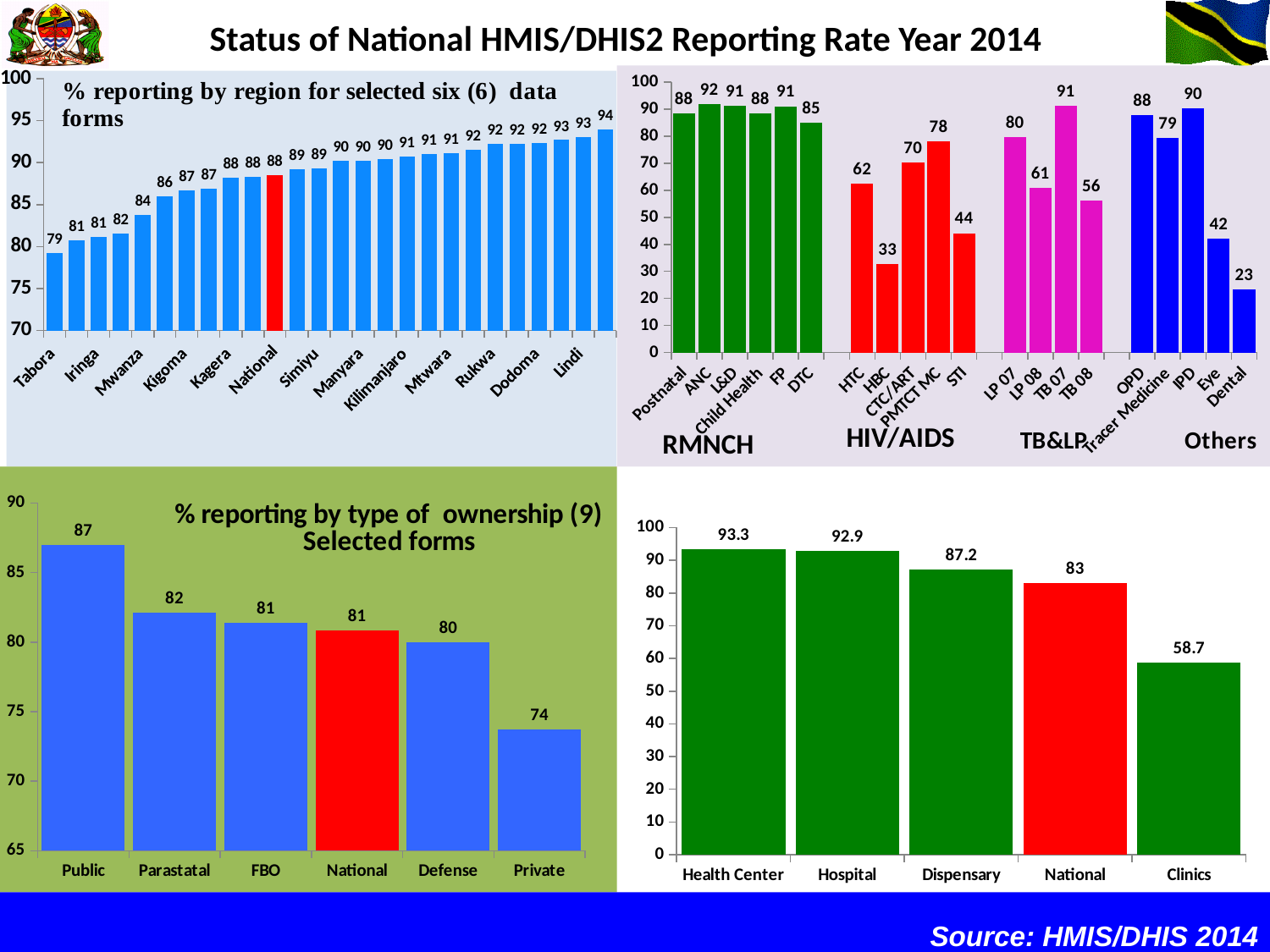
In the top-right chart (RMNCH, HIV/AIDS, TB&LP, Others), what is the value for HBC? 33 In the '% reporting by region for selected six (6) data forms' chart, what is the value of the red National bar? 88 In the '% reporting by type of ownership (9) Selected forms' chart, which ownership type has the lowest reporting rate? Private In the top-right chart (RMNCH, HIV/AIDS, TB&LP, Others), which category has the lowest value? Dental In the top-right chart (RMNCH, HIV/AIDS, TB&LP, Others), which is larger, LP 07 or LP 08? LP 07 What type of chart is the bottom-right chart (by facility type)? Bar chart In the bottom-right chart (by facility type), what is the value for Clinics? 58.7 In the '% reporting by type of ownership (9) Selected forms' chart, what is the difference between Public and Private? 13 In the bottom-right chart (by facility type), how many categories are shown? 5 In the '% reporting by type of ownership (9) Selected forms' chart, what is the value for Public? 87 In the bottom-right chart (by facility type), which facility type has the highest reporting rate? Health Center In the '% reporting by region for selected six (6) data forms' chart, what is the value for Tabora? 79